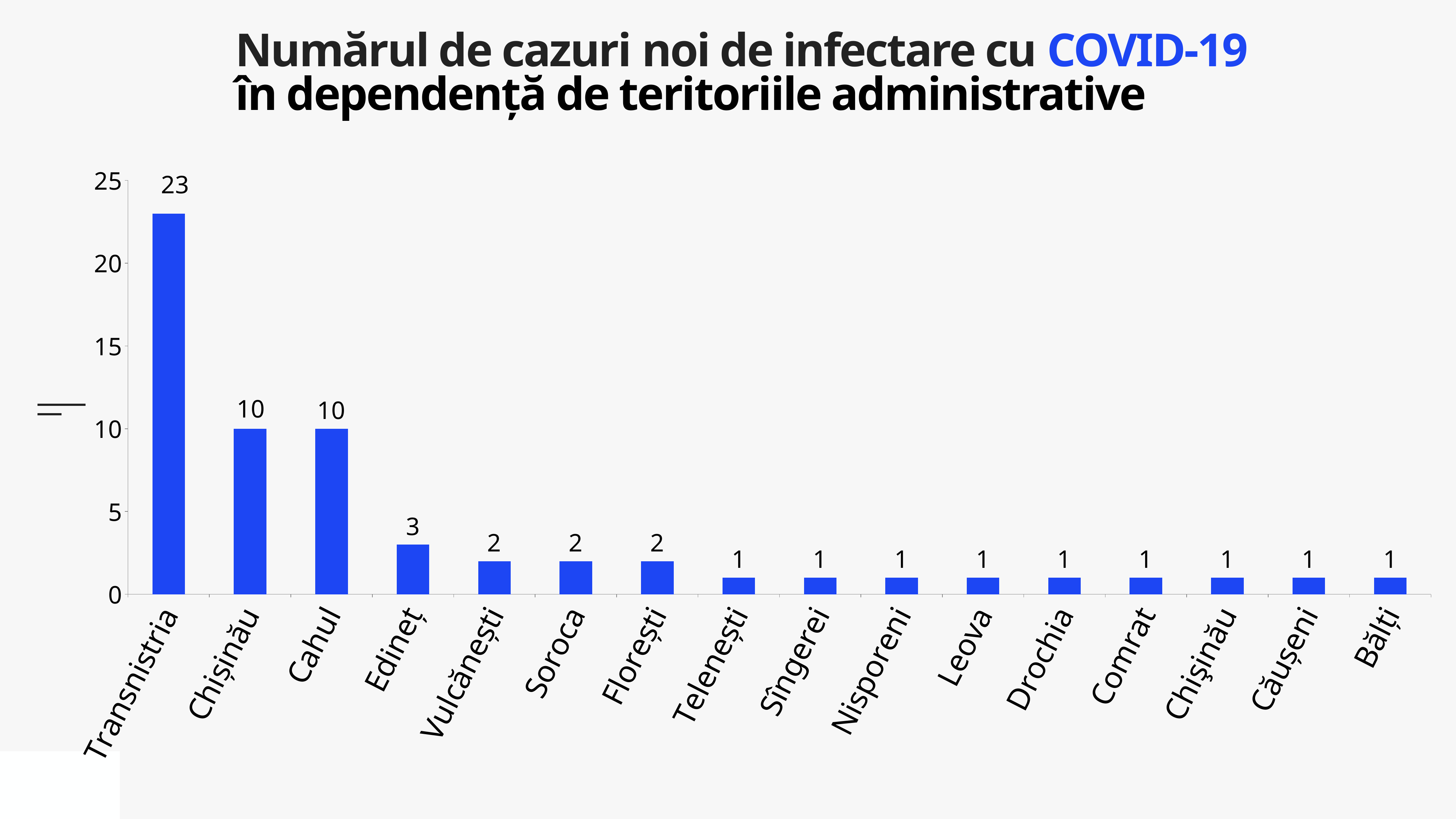
What is the difference between the values for Edineț and Vulcănești? 1 What is the value for Transnistria? 23 What is the value for Bălți? 1 Which category has the highest value? Transnistria What is the value for Cahul? 10 Which is larger, the value for Cahul or the value for Florești? Cahul Is the value for Transnistria greater or less than 20? greater What is the value for Edineț? 3 What kind of chart is shown on the slide? bar chart What is the value for Soroca? 2 How many bars are shown in the chart? 16 What is the difference between the values for Transnistria and Cahul? 13